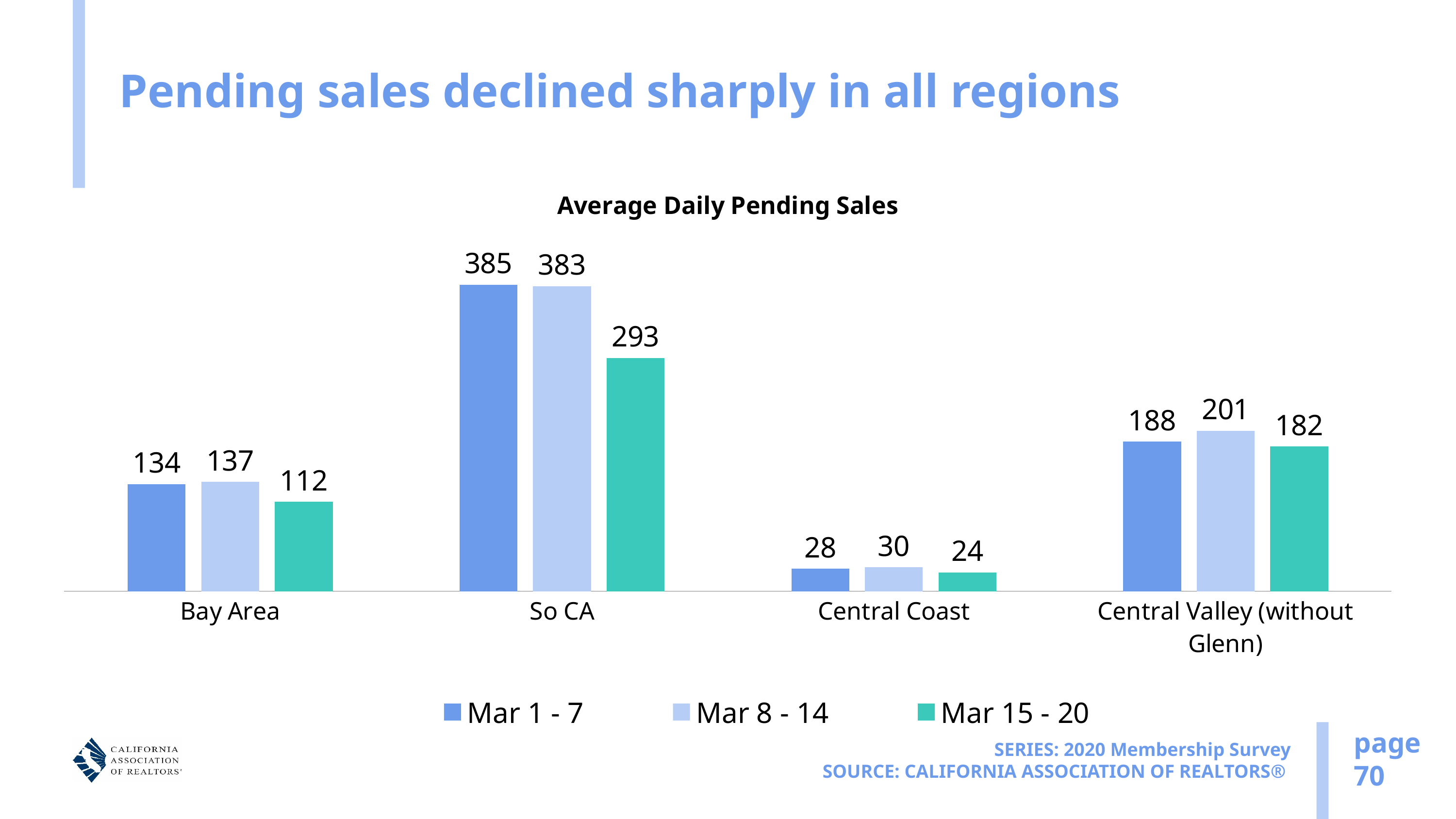
How many series does the legend list? 3 Which is larger for Central Valley (without Glenn): the Mar 1 - 7 value or the Mar 15 - 20 value? Mar 1 - 7 What is the Mar 1 - 7 value for the Bay Area? 134 What is the title of the chart? Average Daily Pending Sales What is the difference between the Mar 8 - 14 and Mar 15 - 20 values for So CA? 90 What is the difference between the Mar 1 - 7 and Mar 15 - 20 values for the Bay Area? 22 Which region has the lowest value in the Mar 15 - 20 series? Central Coast What kind of chart is shown on the slide? Bar chart What is the average daily pending sales value for So CA in the Mar 15 - 20 period? 293 Which region has the highest value in the Mar 1 - 7 series? So CA How many regions are shown on the x axis? 4 What is the Mar 8 - 14 value for Central Valley (without Glenn)? 201